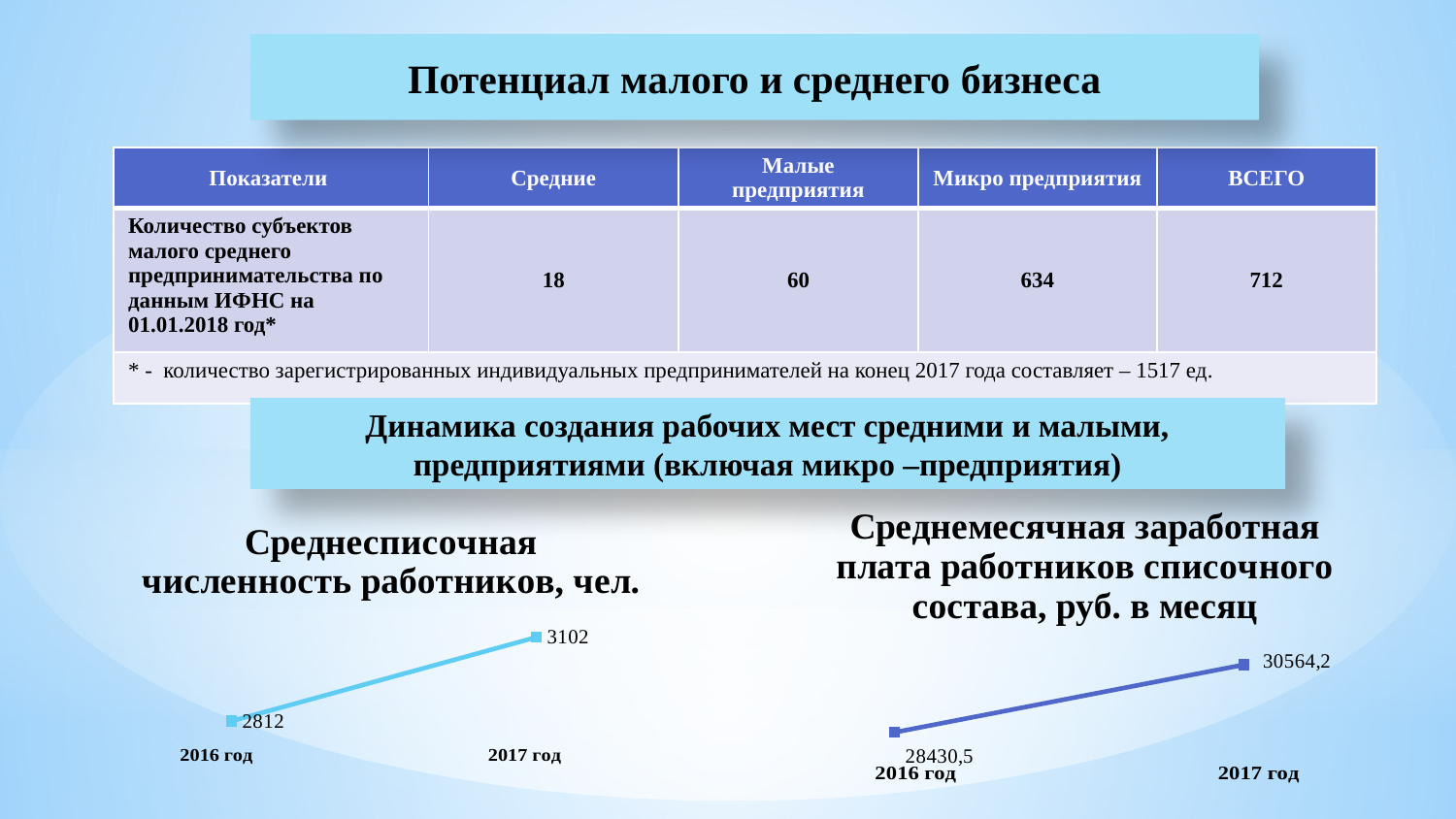
What kind of chart is the left chart (Среднесписочная численность работников, чел.)? line chart On the right chart (Среднемесячная заработная плата работников списочного состава, руб. в месяц), what is the value for 2016 год? 28430,5 On the left chart (Среднесписочная численность работников, чел.), what is the value for 2017 год? 3102 On the right chart (Среднемесячная заработная плата работников списочного состава, руб. в месяц), does the value rise or fall from 2016 год to 2017 год? rise On the right chart (Среднемесячная заработная плата работников списочного состава, руб. в месяц), what is the value for 2017 год? 30564,2 How many data points are plotted on the right chart (Среднемесячная заработная плата работников списочного состава, руб. в месяц)? 2 On the left chart (Среднесписочная численность работников, чел.), by how much did the value increase from 2016 год to 2017 год? 290 On the left chart (Среднесписочная численность работников, чел.), does the value rise or fall from 2016 год to 2017 год? rise On the left chart (Среднесписочная численность работников, чел.), what is the value for 2016 год? 2812 On the right chart (Среднемесячная заработная плата работников списочного состава, руб. в месяц), which year has the lower value? 2016 год On the left chart (Среднесписочная численность работников, чел.), which year has the higher value? 2017 год On the right chart (Среднемесячная заработная плата работников списочного состава, руб. в месяц), what is the difference between the 2017 год and 2016 год values? 2133,7